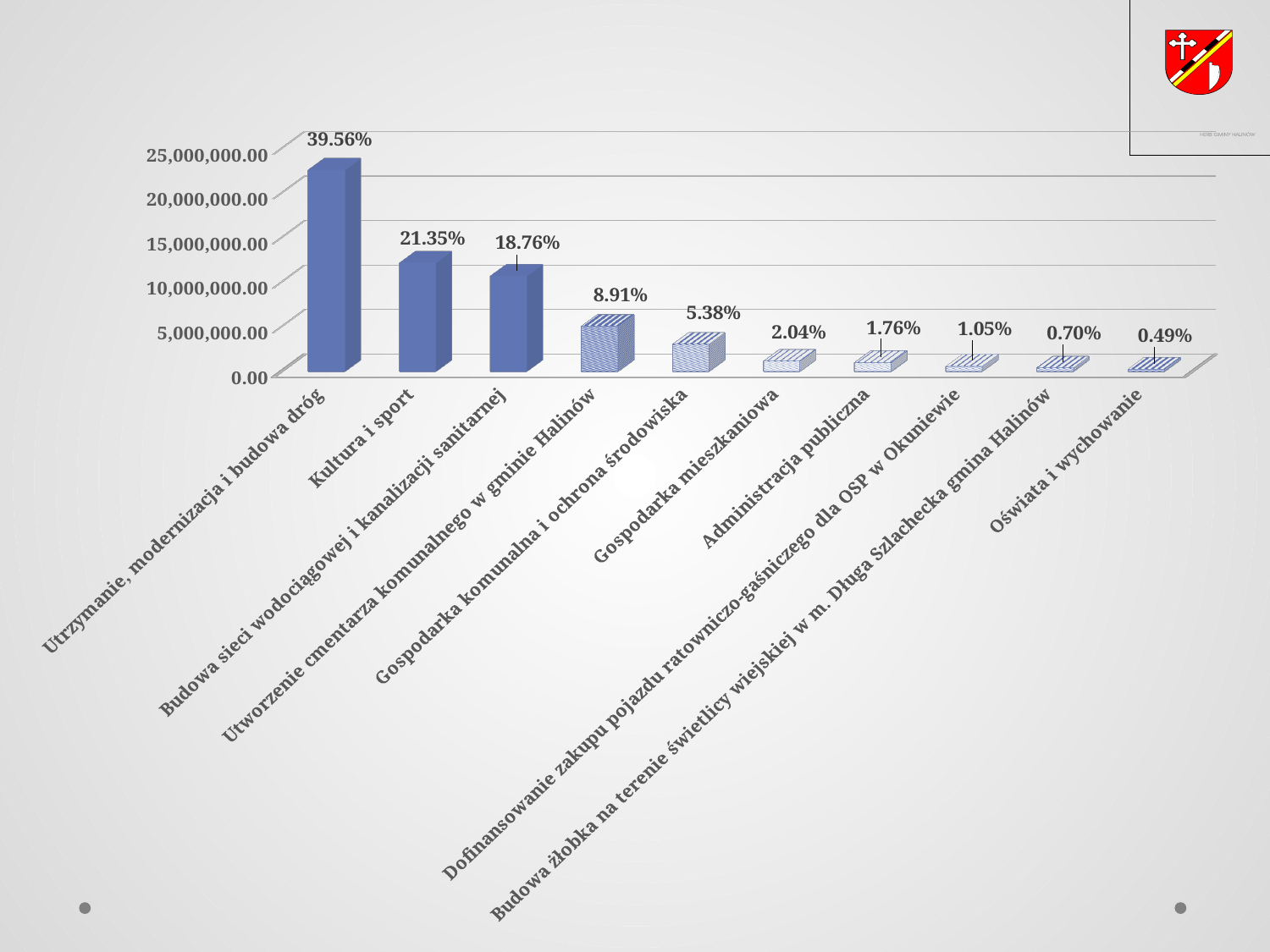
Which is larger, the bar for "Kultura i sport" or the bar for "Budowa sieci wodociągowej i kanalizacji sanitarnej"? Kultura i sport Which category has the lowest bar? Oświata i wychowanie What data label is shown on the bar for "Administracja publiczna"? 1.76% What data label is shown on the bar for "Gospodarka mieszkaniowa"? 2.04% Is the value for "Gospodarka komunalna i ochrona środowiska" greater or less than 5,000,000.00? less Is the value for "Utrzymanie, modernizacja i budowa dróg" greater or less than 20,000,000.00? greater What is the difference between the percentage labels for "Utrzymanie, modernizacja i budowa dróg" and "Kultura i sport"? 18.21% Do the bar values rise or fall from left to right along the x axis? Fall How many categories are shown on the chart? 10 What kind of chart is shown on the slide? Bar chart Which category has the highest bar? Utrzymanie, modernizacja i budowa dróg What data label is shown on the bar for "Kultura i sport"? 21.35%